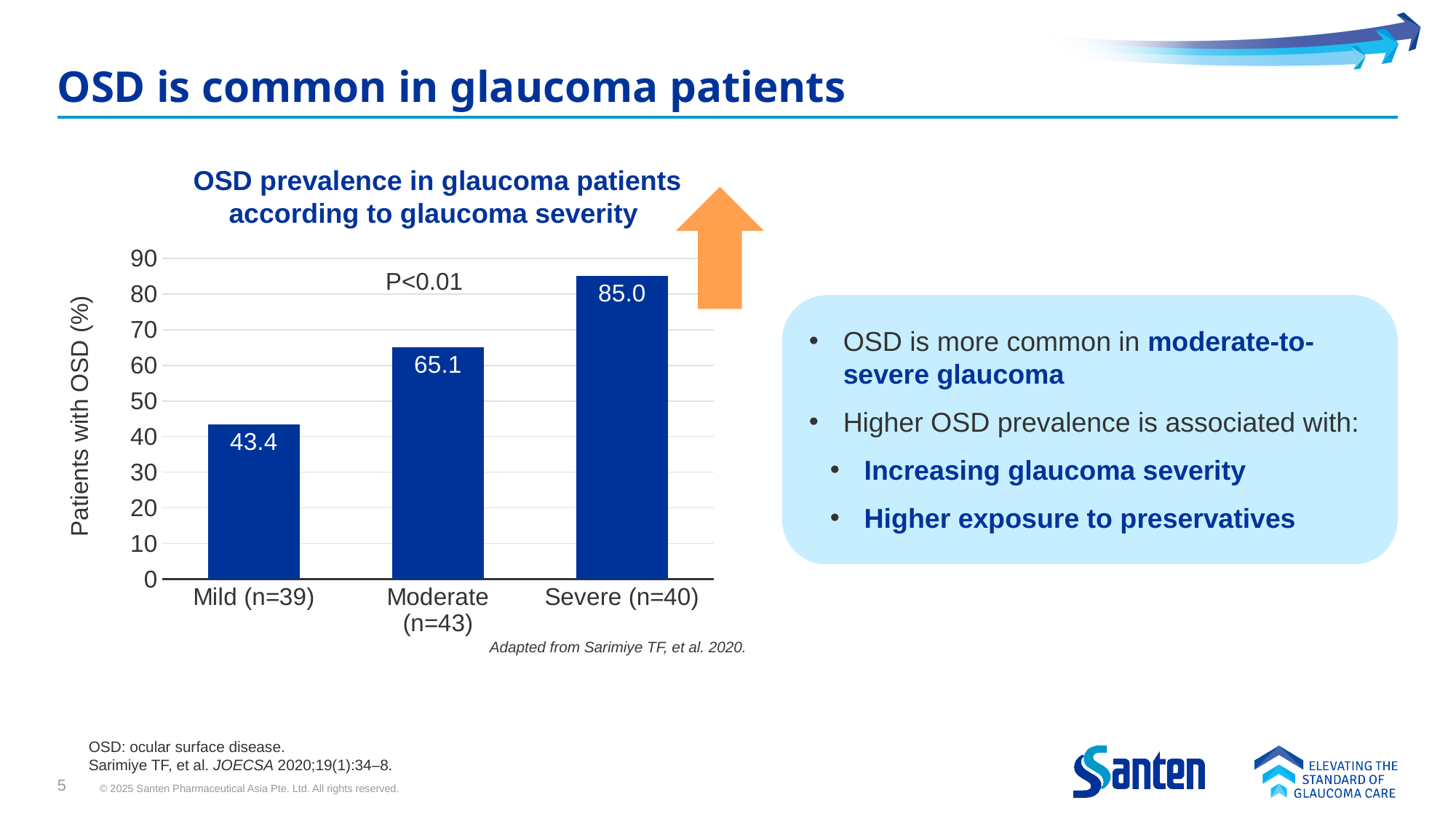
What kind of chart is used to show OSD prevalence by glaucoma severity? Bar chart Is the value for the Moderate (n=43) group greater or less than 60? greater What is the percentage of patients with OSD in the Moderate (n=43) group? 65.1 What is the percentage of patients with OSD in the Severe (n=40) group? 85.0 What is the percentage of patients with OSD in the Mild (n=39) group? 43.4 How many glaucoma severity groups are shown in the chart? 3 Which glaucoma severity group has the lowest OSD prevalence? Mild (n=39) What is the difference in OSD prevalence between the Severe and Mild groups? 41.6 Does OSD prevalence rise or fall as glaucoma severity increases from Mild to Severe? Rises What is the difference in OSD prevalence between the Moderate and Mild groups? 21.7 Which group has a higher OSD prevalence, Moderate or Severe? Severe Which glaucoma severity group has the highest OSD prevalence? Severe (n=40)